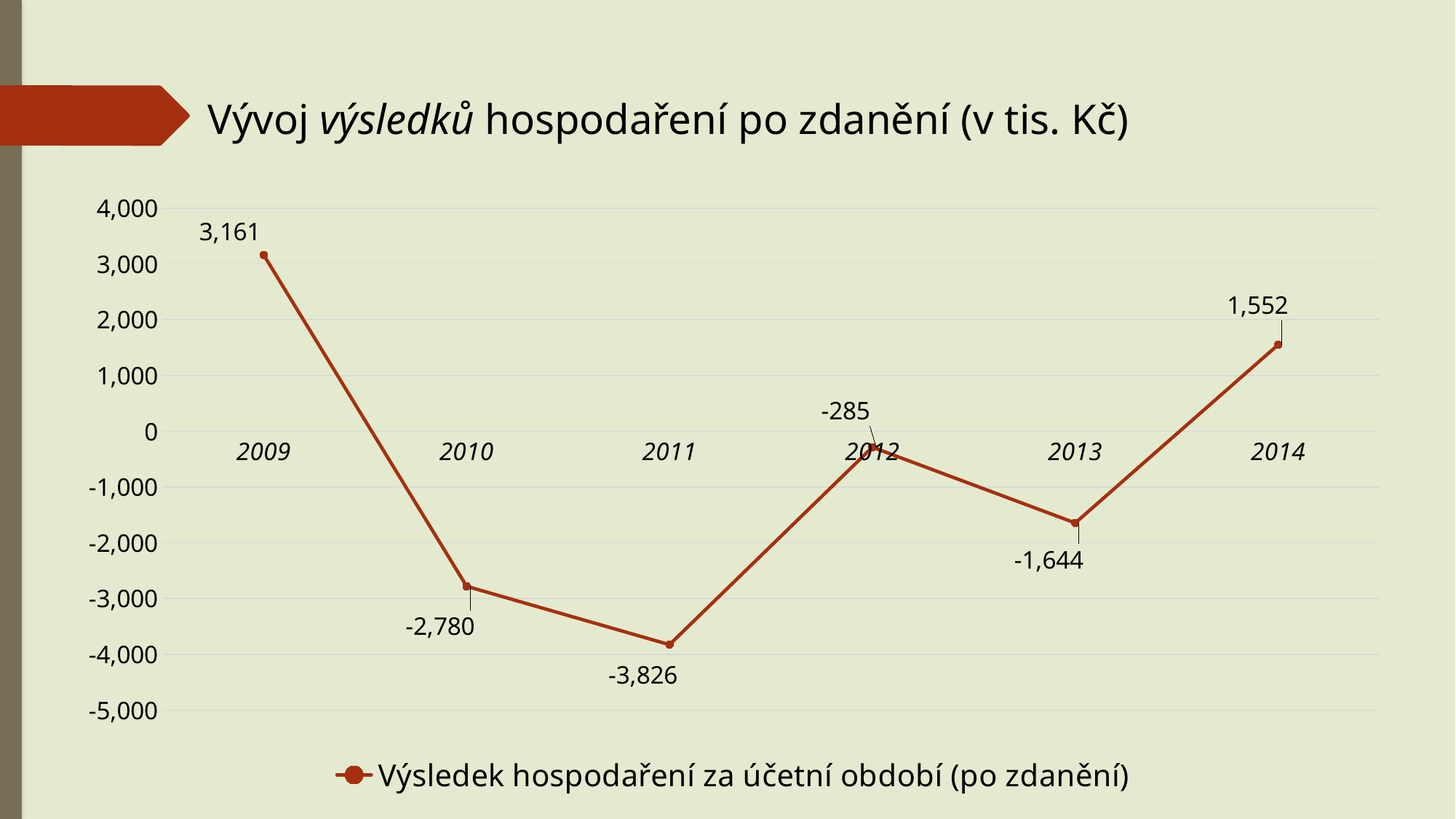
Which year has the lowest value? 2011 What kind of chart is shown on the slide? line chart Which year has the highest value? 2009 How many years are plotted on the chart? 6 What is the value for 2012? -285 What is the value for 2014? 1,552 What is the value for 2011? -3,826 What is the difference between the values for 2010 and 2013? 1,136 Which is larger, the value for 2012 or the value for 2013? 2012 What is the difference between the values for 2009 and 2014? 1,609 What is the value for 2009? 3,161